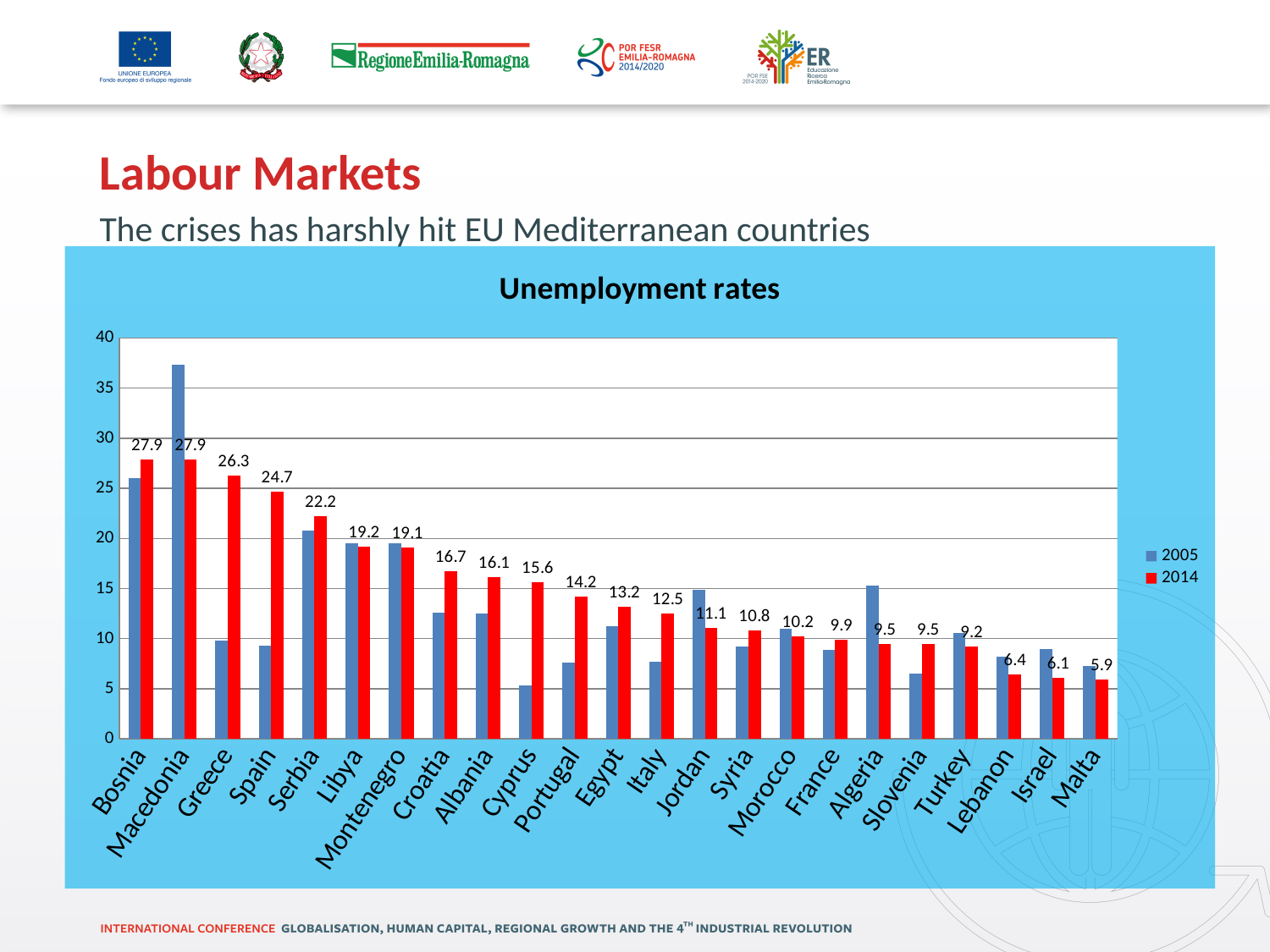
Which country has the highest 2005 unemployment rate? Macedonia Is the 2005 unemployment rate for Cyprus greater or less than 10? less What is the title of the chart? Unemployment rates What is the 2014 unemployment rate for Italy? 12.5 What is the 2014 unemployment rate for Greece? 26.3 Is the 2005 unemployment rate for Macedonia greater or less than 35? greater Which country has the lowest 2014 unemployment rate? Malta How many countries are shown on the x axis of the chart? 23 What is the difference between the 2014 unemployment rates of Greece and Spain? 1.6 What type of chart is shown on the slide? bar chart Which is larger, the 2014 unemployment rate for Croatia or for Albania? Croatia How many series does the legend list? 2